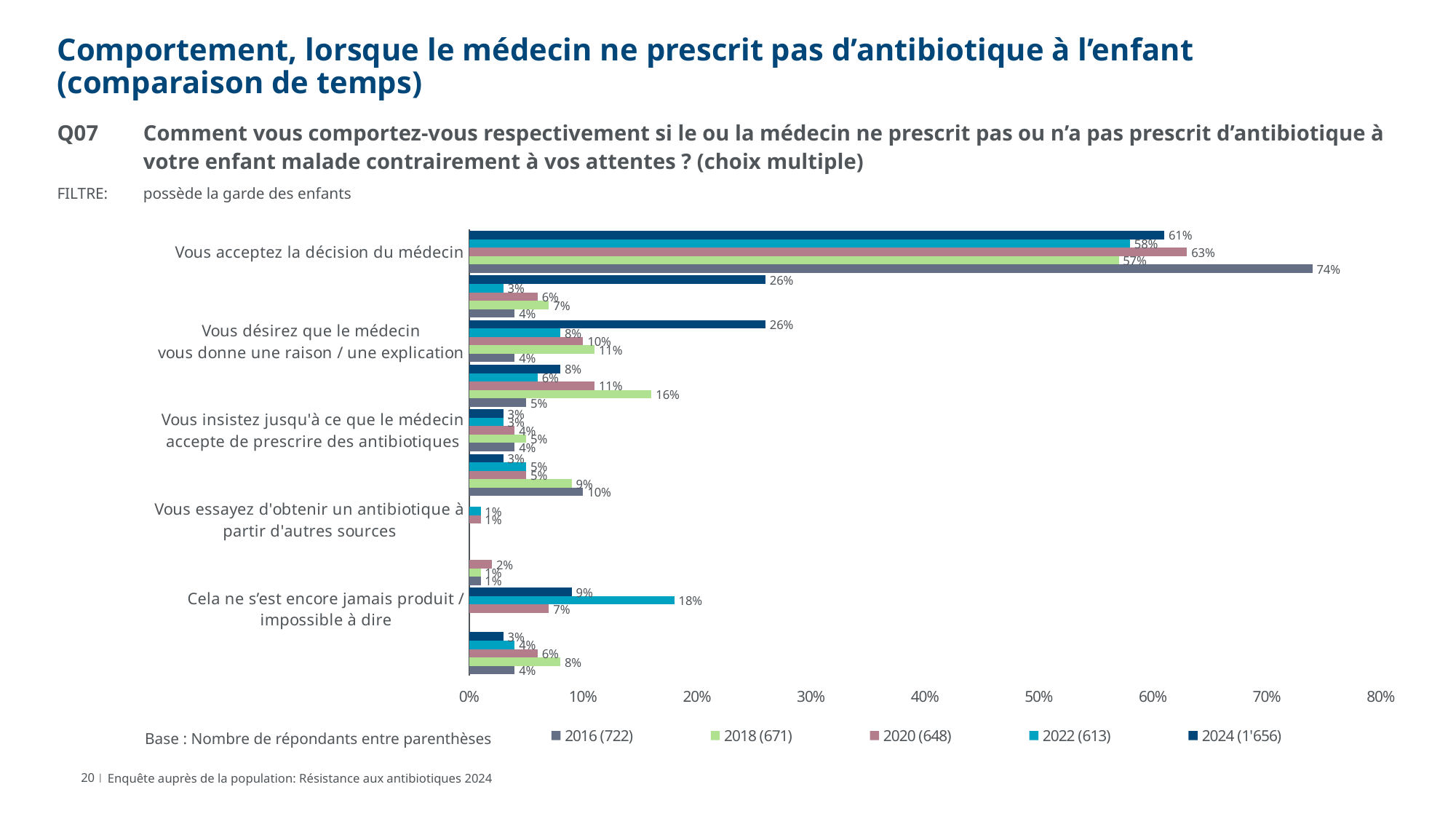
What is the 2024 value for "Vous acceptez la décision du médecin"? 61% What is the 2018 value for "Vous acceptez la décision du médecin"? 57% What is the difference between the 2016 and 2024 values for "Vous acceptez la décision du médecin"? 13 percentage points Is the 2016 value for "Vous acceptez la décision du médecin" greater or less than 70%? greater What kind of chart is shown on the slide? Bar chart What is the 2016 value for "Vous acceptez la décision du médecin"? 74% How many series does the legend list? 5 What is the 2020 value for "Vous acceptez la décision du médecin"? 63% Which survey year has the lowest value for "Vous acceptez la décision du médecin"? 2018 For "Vous acceptez la décision du médecin", which is larger: the 2020 value or the 2022 value? 2020 What is the 2022 value for "Vous acceptez la décision du médecin"? 58% Which survey year has the highest value for "Vous acceptez la décision du médecin"? 2016